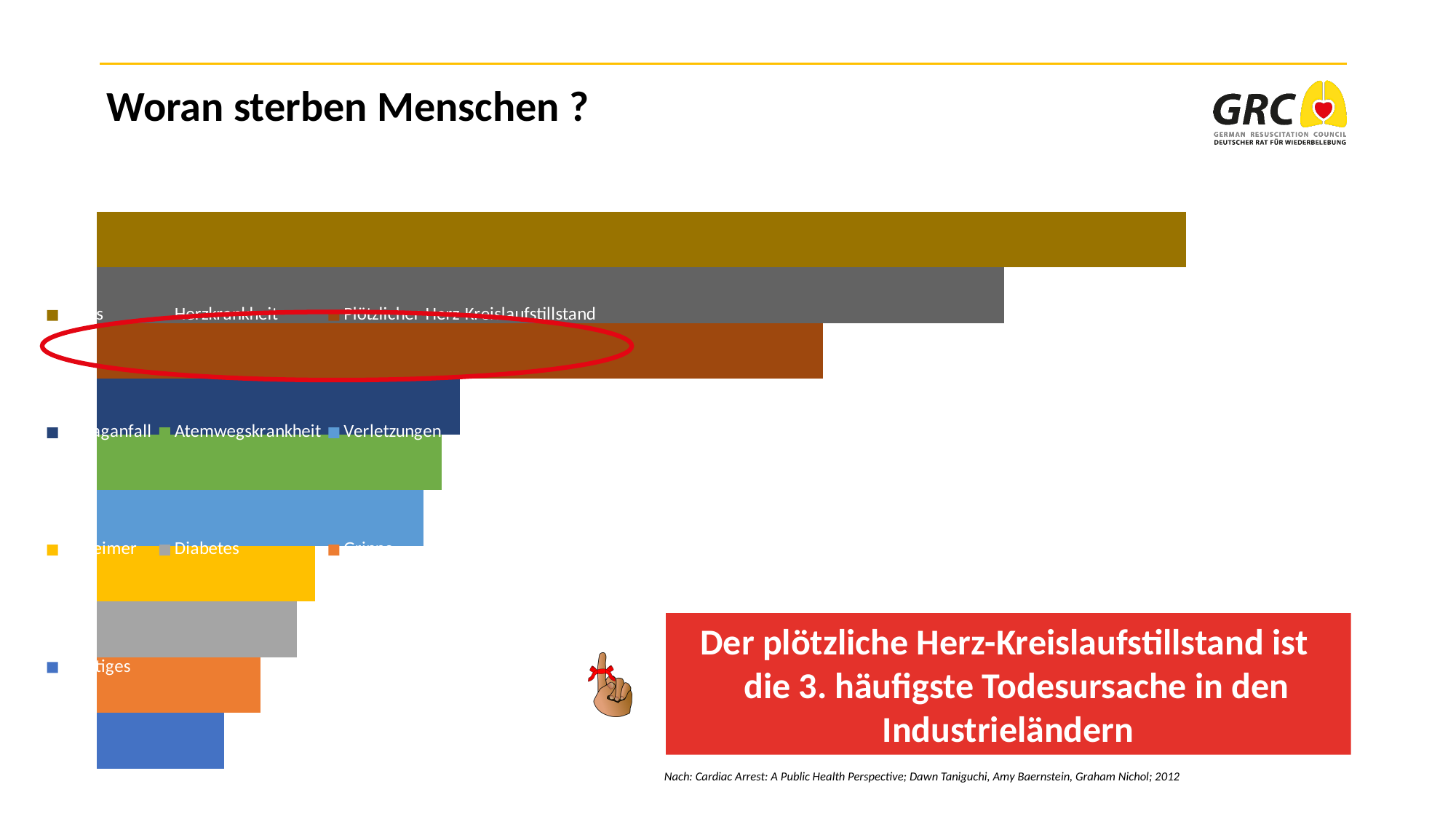
In the ranking of bar lengths, what position does Plötzlicher Herz-Kreislaufstillstand hold? third Which is larger, the bar for Herzkrankheit or the bar for Plötzlicher Herz-Kreislaufstillstand? Herzkrankheit Which is larger, the bar for Verletzungen or the bar for Diabetes? Verletzungen What is the title of the slide containing the chart? Woran sterben Menschen ? What kind of chart is shown on the slide? bar chart Which bar in the chart is circled in red? Plötzlicher Herz-Kreislaufstillstand How many bars are plotted in the chart? 10 Do the bars get longer or shorter going from the top of the chart to the bottom? shorter